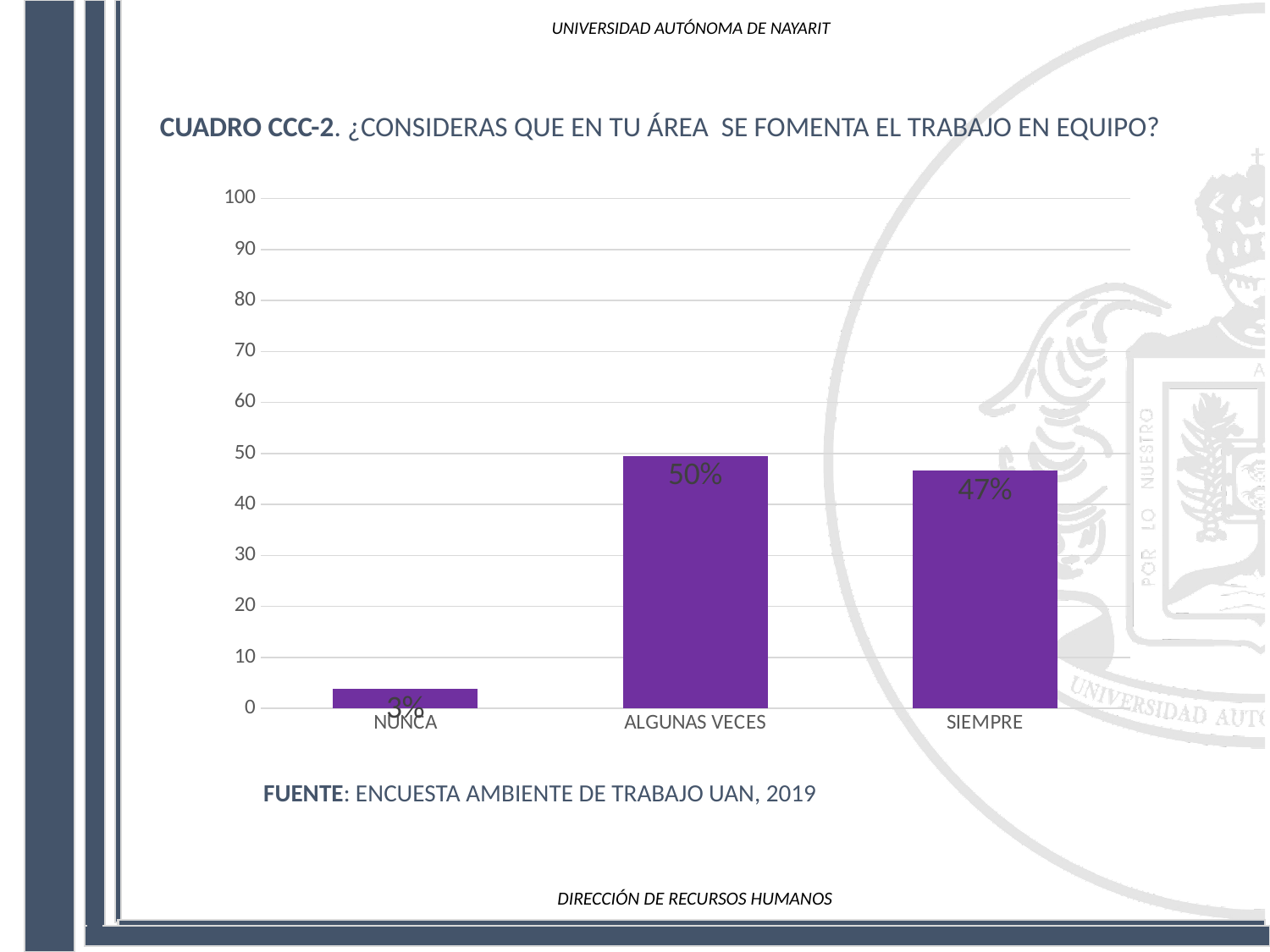
Which is larger, the value for SIEMPRE or the value for NUNCA? SIEMPRE Is the value for SIEMPRE greater or less than 40? greater What is the difference between the values for ALGUNAS VECES and SIEMPRE? 3 percentage points What is the value for ALGUNAS VECES? 50% What is the value for NUNCA? 3% What source is cited below the chart? ENCUESTA AMBIENTE DE TRABAJO UAN, 2019 What kind of chart is shown on the slide? bar chart Which category has the highest value? ALGUNAS VECES What is the value for SIEMPRE? 47% Which category has the lowest value? NUNCA How many categories are shown on the x axis? 3 Is the value for NUNCA greater or less than 10? less